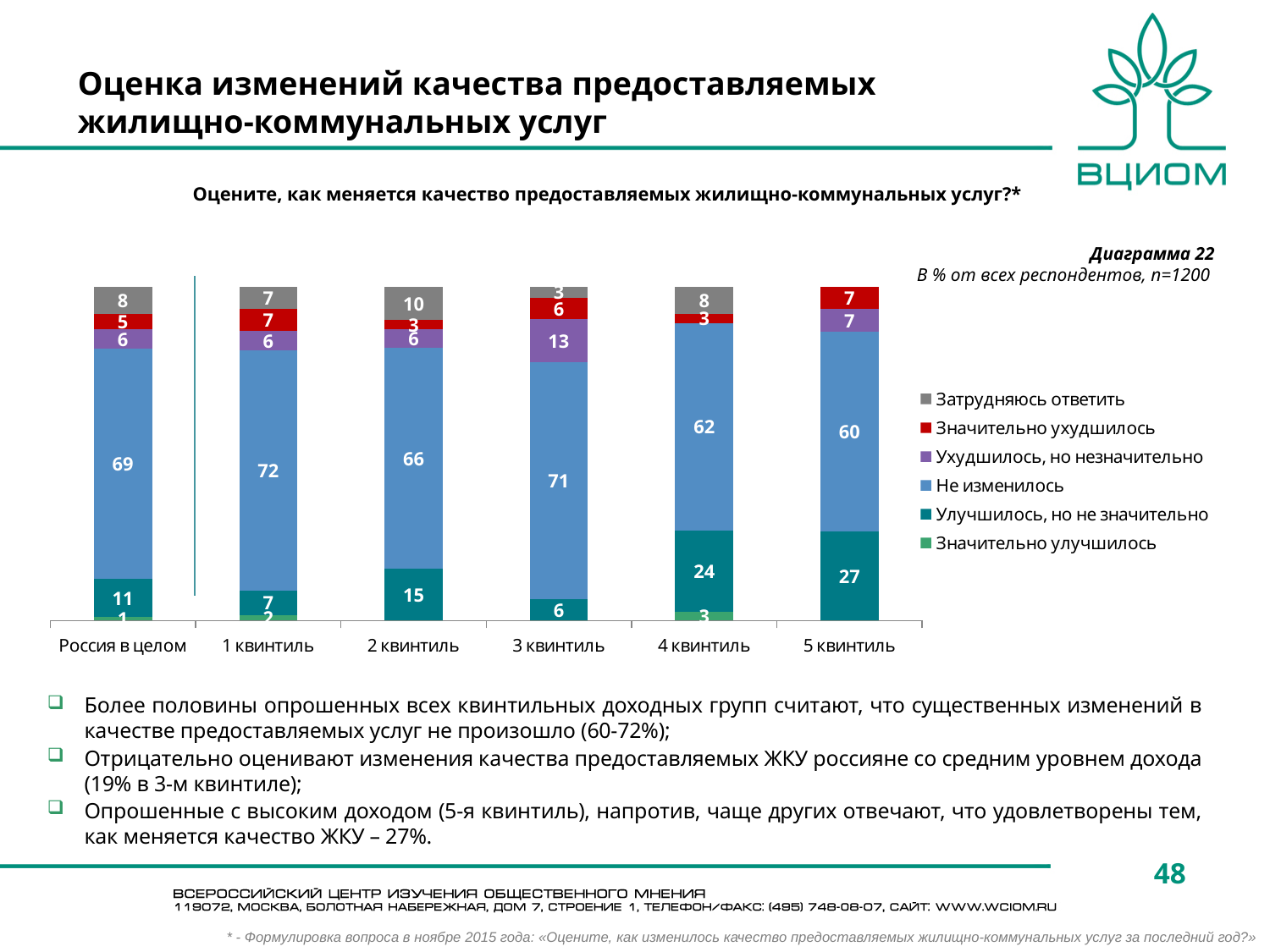
What is the value of "Ухудшилось, но незначительно" for "3 квинтиль"? 13 What is the value of "Не изменилось" for "3 квинтиль"? 71 What is the diagram number given above the chart? Диаграмма 22 What is the value of "Не изменилось" for "Россия в целом"? 69 What kind of chart is shown on the slide? stacked bar chart What is the value of "Улучшилось, но не значительно" for "5 квинтиль"? 27 Which is larger: the "Улучшилось, но не значительно" value for "2 квинтиль" or for "4 квинтиль"? 4 квинтиль How many categories are shown along the x axis of the chart? 6 Which category has the lowest value for "Не изменилось"? 5 квинтиль Which category has the highest value for "Не изменилось"? 1 квинтиль What is the difference between the "Улучшилось, но не значительно" values for "5 квинтиль" and "3 квинтиль"? 21 How many series does the chart legend list? 6